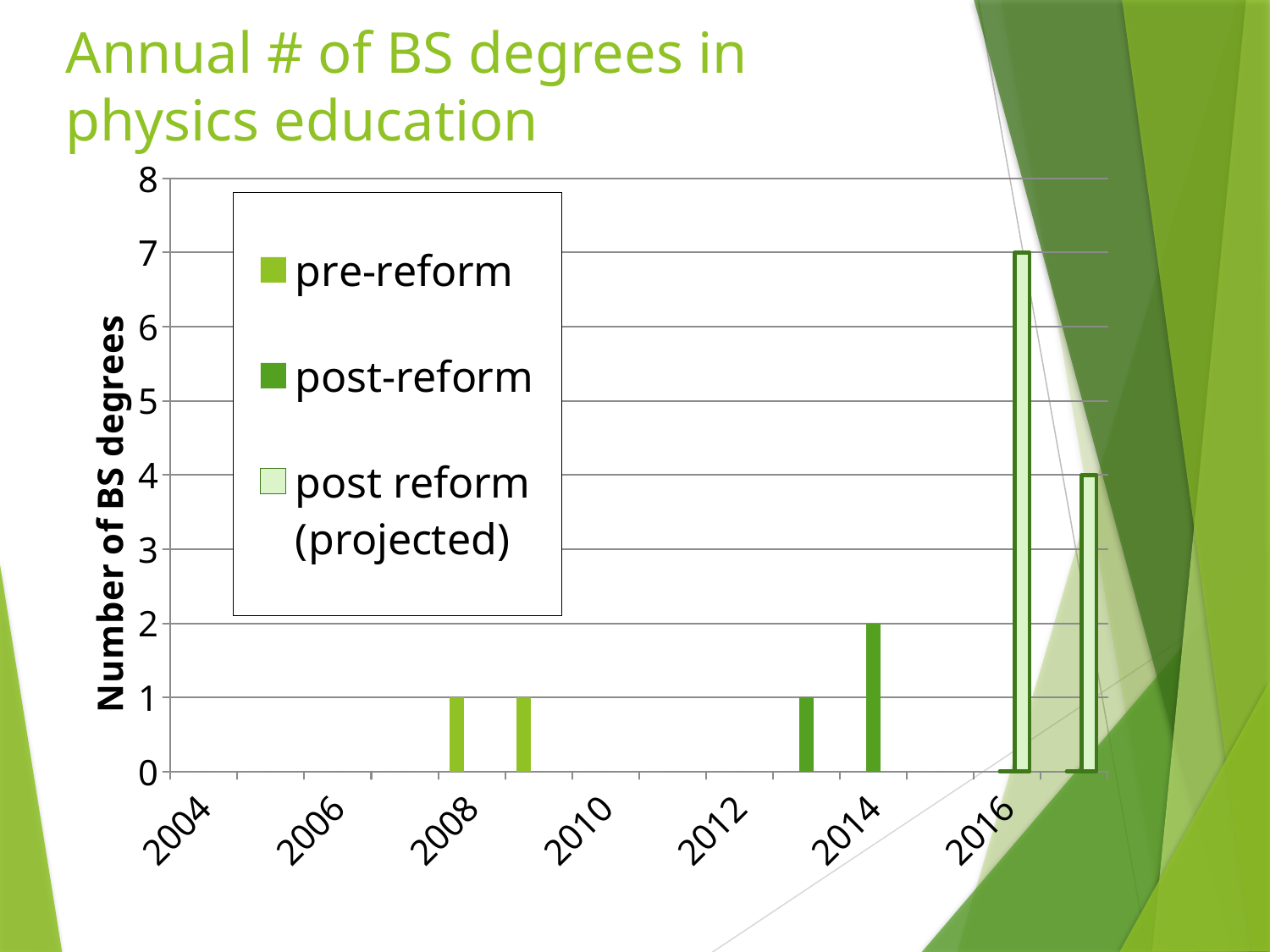
What is the difference between the number of BS degrees in 2014 and in 2013? 1 Which year has the highest number of BS degrees? 2016 Which legend entry is shown with the lightest green colour? post reform (projected) What kind of chart is shown on the slide? bar chart Is the value for 2016 greater or less than 5? greater What is the number of BS degrees for 2014? 2 What is the title of the vertical axis? Number of BS degrees Which year has more BS degrees, 2013 or 2014? 2014 What is the number of BS degrees for 2013? 1 What is the number of BS degrees for 2008? 1 What is the number of BS degrees for 2016? 7 How many series does the legend list? 3